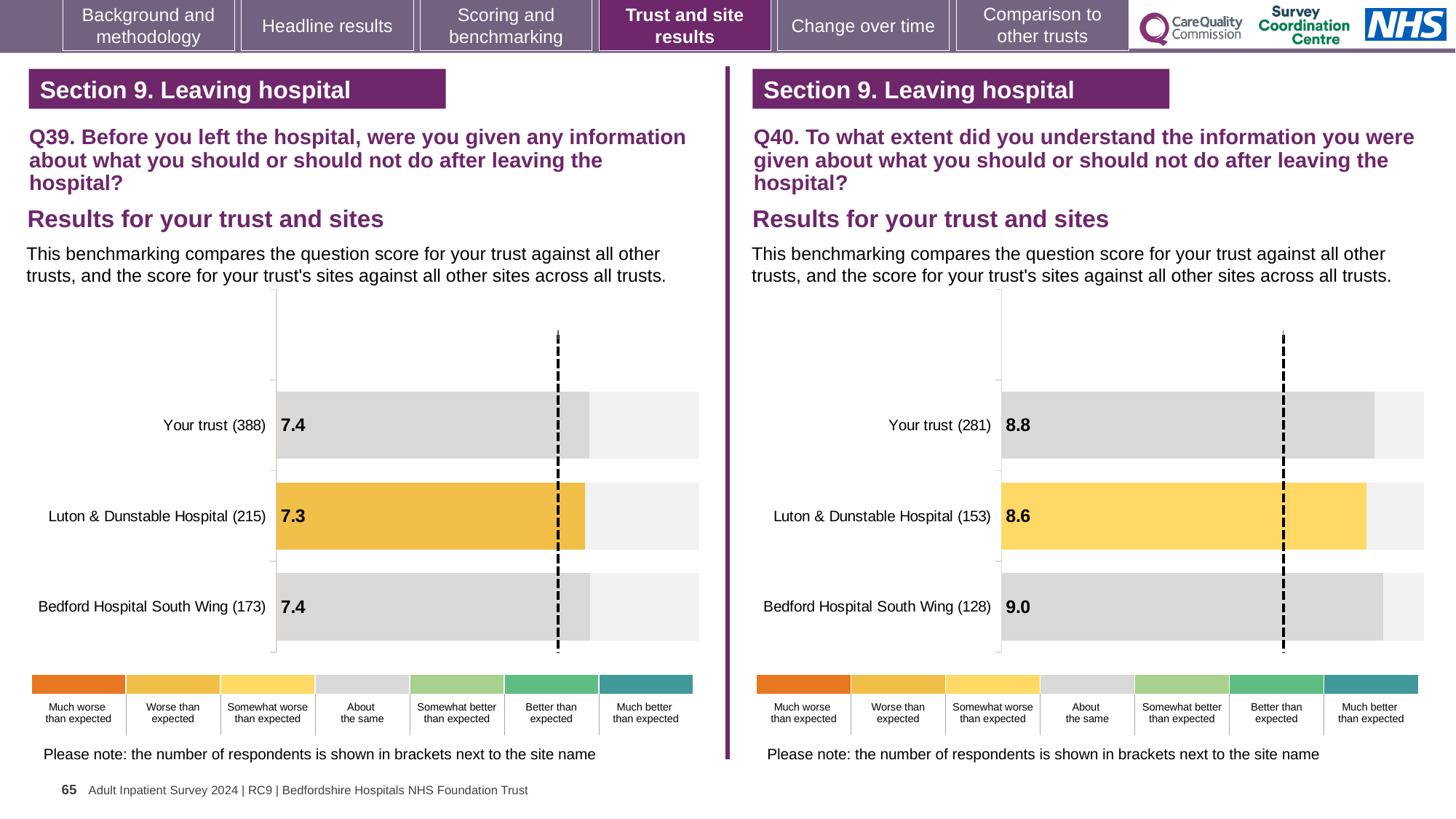
How many bars are plotted in the Q39 chart on the left? 3 In the Q39 chart on the left, how many respondents are shown in brackets for Bedford Hospital South Wing? 173 In the Q40 chart on the right, what is the difference between the scores for Bedford Hospital South Wing and Luton & Dunstable Hospital? 0.4 In the Q39 chart on the left, what is the score for Your trust? 7.4 In the Q40 chart on the right, is the score for Your trust higher or lower than the score for Luton & Dunstable Hospital? higher In the Q39 chart on the left, what is the difference between the scores for Your trust and Luton & Dunstable Hospital? 0.1 In the Q40 chart on the right, which site or trust has the lowest score? Luton & Dunstable Hospital In the Q39 chart on the left, what is the score for Luton & Dunstable Hospital? 7.3 In the Q40 chart on the right, which site or trust has the highest score? Bedford Hospital South Wing In the Q40 chart on the right, what is the score for Luton & Dunstable Hospital? 8.6 What type of chart is used for the Q40 results on the right? bar chart In the Q40 chart on the right, what is the score for Bedford Hospital South Wing? 9.0